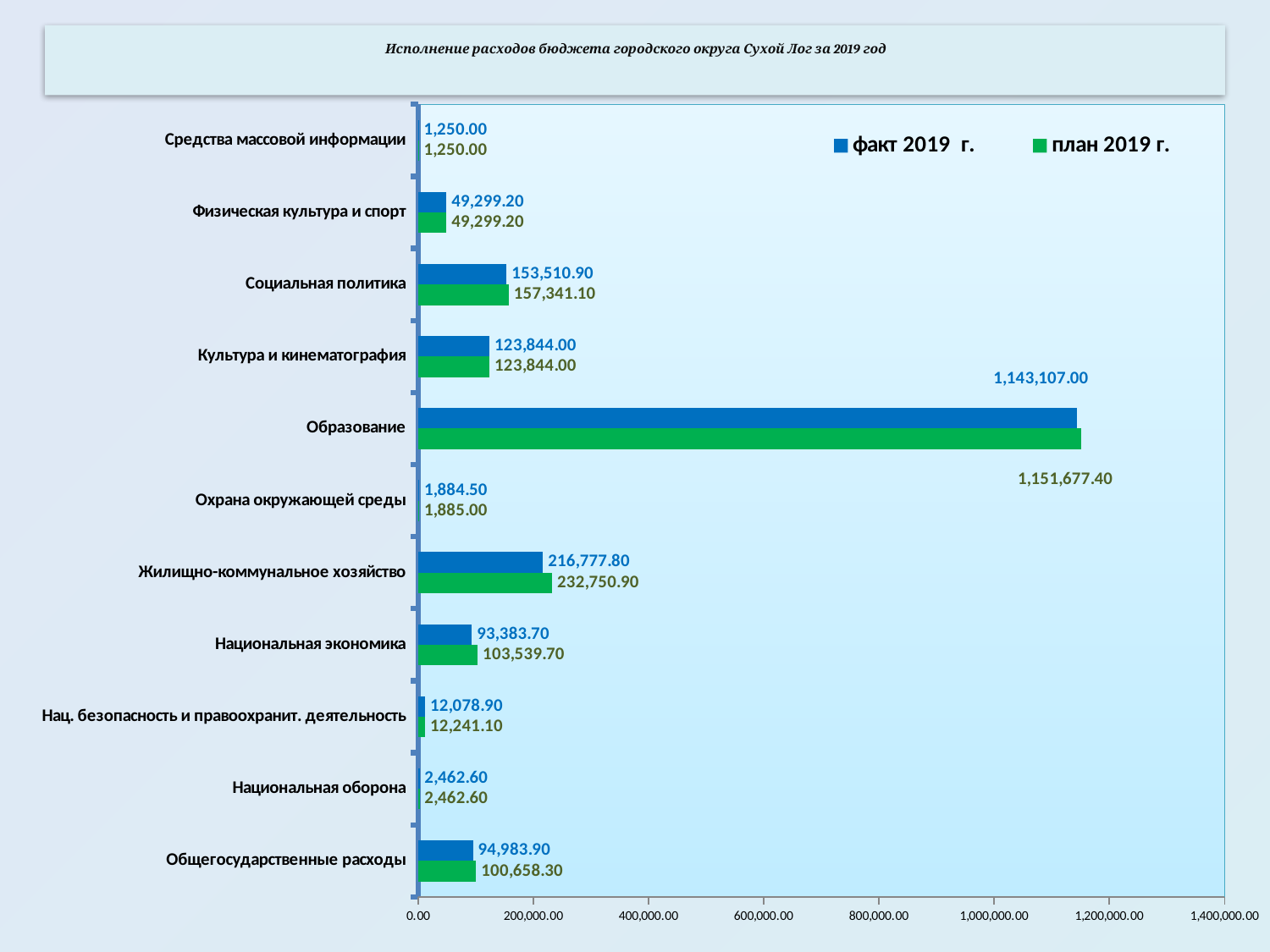
Which category has the lowest план 2019 г. value? Средства массовой информации What is the difference between the план 2019 г. and факт 2019 г. values for Социальная политика? 3,830.20 How many series does the legend list? 2 Which has the larger факт 2019 г. value: Культура и кинематография or Социальная политика? Социальная политика What type of chart is shown on the slide? bar chart What is the факт 2019 г. value for Образование? 1,143,107.00 What is the title of the chart? Исполнение расходов бюджета городского округа Сухой Лог за 2019 год What is the план 2019 г. value for Образование? 1,151,677.40 Which category has the highest факт 2019 г. value? Образование How many categories are shown on the chart? 11 What is the план 2019 г. value for Национальная экономика? 103,539.70 What is the факт 2019 г. value for Жилищно-коммунальное хозяйство? 216,777.80